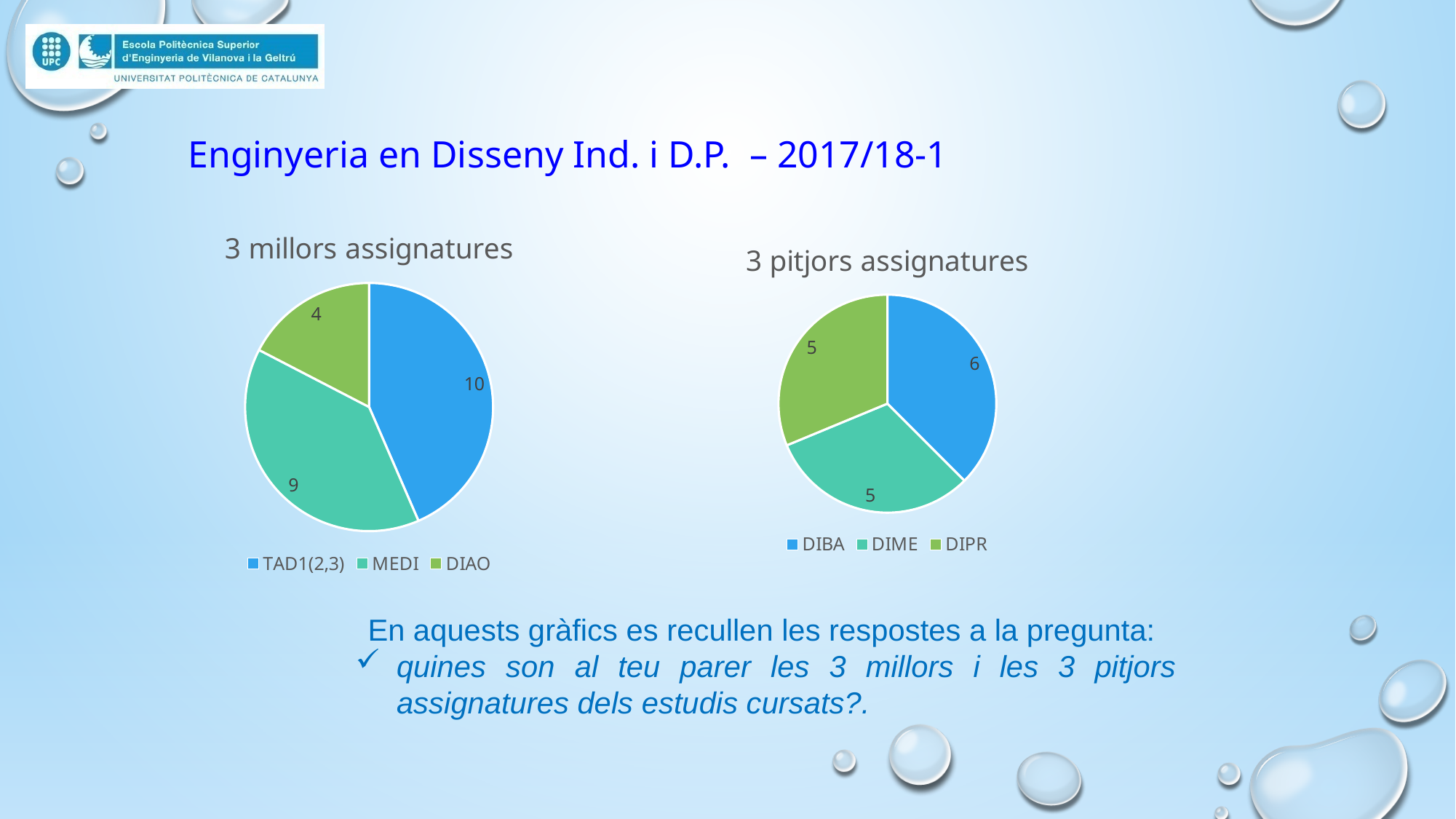
How many entries does the legend of the '3 pitjors assignatures' chart list? 3 In the '3 pitjors assignatures' chart, what is the total of all slices? 16 In the '3 pitjors assignatures' chart, which subject has the largest slice? DIBA In the '3 millors assignatures' chart, what is the value for TAD1(2,3)? 10 In the '3 millors assignatures' chart, what is the value for DIAO? 4 In the '3 millors assignatures' chart, which subject has the largest slice? TAD1(2,3) In the '3 pitjors assignatures' chart, what is the value for DIME? 5 What kind of chart is the '3 millors assignatures' chart? Pie chart In the '3 millors assignatures' chart, which subject has the smallest slice? DIAO In the '3 millors assignatures' chart, what is the total of all slices? 23 In the '3 millors assignatures' chart, what is the difference between the values for MEDI and DIAO? 5 In the '3 pitjors assignatures' chart, what is the value for DIBA? 6